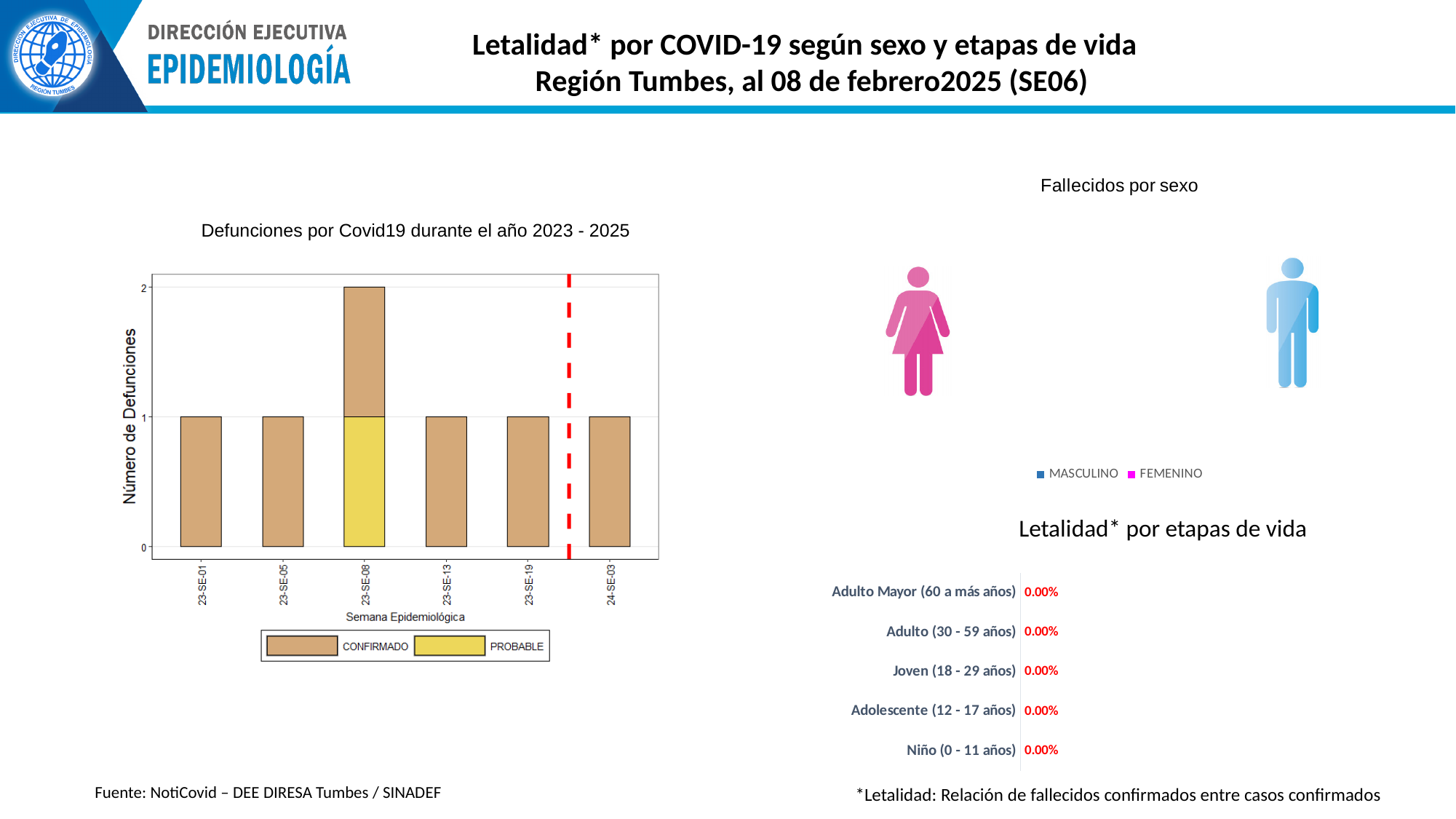
How many life-stage categories are shown in the chart 'Letalidad* por etapas de vida'? 5 What kind of chart is 'Defunciones por Covid19 durante el año 2023 - 2025'? bar chart How many series does the legend of 'Defunciones por Covid19 durante el año 2023 - 2025' list? 2 What is the x-axis title of the chart 'Defunciones por Covid19 durante el año 2023 - 2025'? Semana Epidemiológica In the chart 'Defunciones por Covid19 durante el año 2023 - 2025', how many CONFIRMADO deaths are shown for 23-SE-01? 1 In the chart 'Defunciones por Covid19 durante el año 2023 - 2025', what is the difference between the total deaths in 23-SE-08 and in 24-SE-03? 1 In the chart 'Defunciones por Covid19 durante el año 2023 - 2025', which week has more total deaths, 23-SE-08 or 23-SE-13? 23-SE-08 In the chart 'Defunciones por Covid19 durante el año 2023 - 2025', which week has the highest total number of deaths? 23-SE-08 In the chart 'Defunciones por Covid19 durante el año 2023 - 2025', what is the total number of deaths for 23-SE-08? 2 In the chart 'Defunciones por Covid19 durante el año 2023 - 2025', how many PROBABLE deaths are shown for 23-SE-08? 1 In the chart 'Letalidad* por etapas de vida', what is the value for Adulto Mayor (60 a más años)? 0.00% In the chart 'Defunciones por Covid19 durante el año 2023 - 2025', how many epidemiological weeks are shown on the x axis? 6